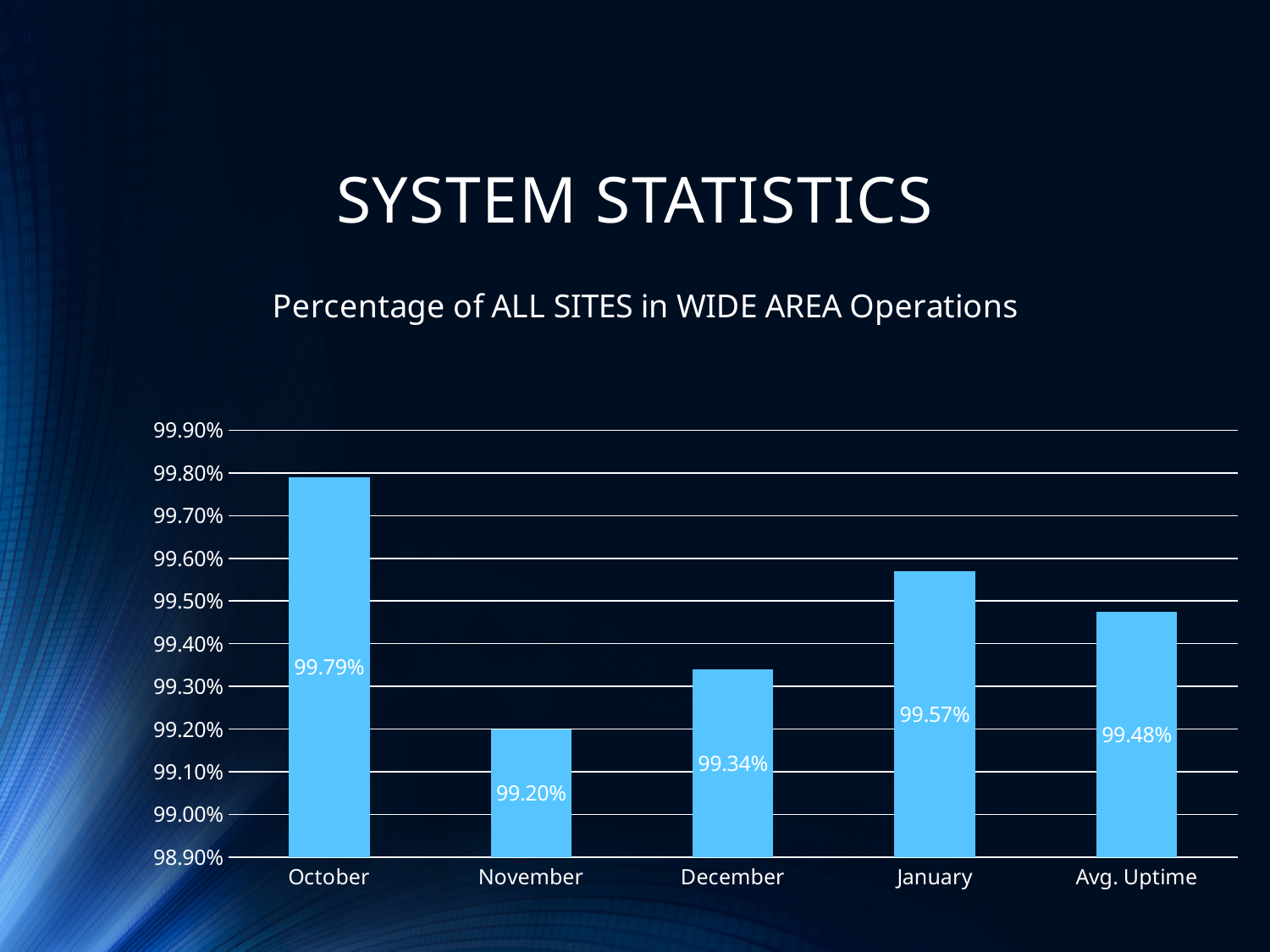
Is the value for December greater or less than 99.50%? less What is the title of the chart? Percentage of ALL SITES in WIDE AREA Operations What is the difference between the values for October and November? 0.59% What is the value for October? 99.79% What is the value for January? 99.57% What kind of chart is shown on the slide? bar chart What is the value for November? 99.20% Which category has the lowest value? November What is the value for Avg. Uptime? 99.48% Which category has the highest value? October Which is larger, the value for December or the value for January? January How many categories are shown on the x axis? 5